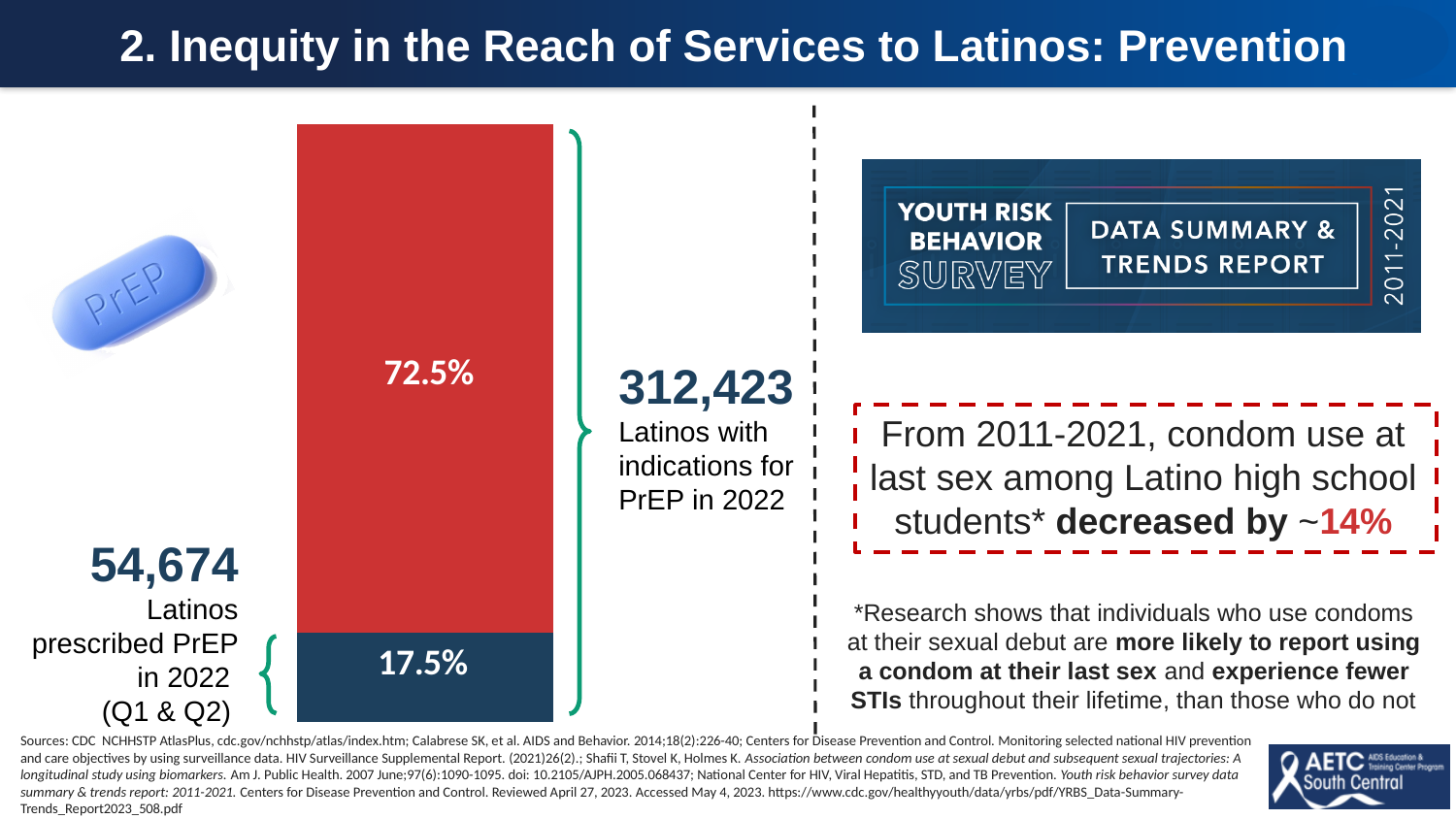
What percentage of Latinos with indications for PrEP were prescribed PrEP in 2022 (Q1 & Q2), according to the bar? 17.5% Is the value of the dark blue segment greater or less than 20%? less Which segment of the stacked bar is larger, the red one or the dark blue one? the red one What kind of chart is shown on the left side of the slide? stacked bar chart What percentage is shown on the dark blue segment at the bottom of the stacked bar? 17.5% What is the combined total of the two labelled segments of the stacked bar? 90% How many Latinos were prescribed PrEP in 2022 (Q1 & Q2), according to the chart label? 54,674 What colour is the segment representing Latinos prescribed PrEP in 2022 (Q1 & Q2)? dark blue How many Latinos had indications for PrEP in 2022, according to the chart label? 312,423 How many segments make up the stacked bar? 2 What is the difference in percentage points between the red segment (72.5%) and the dark blue segment (17.5%)? 55 percentage points What percentage is shown on the red segment of the stacked bar? 72.5%